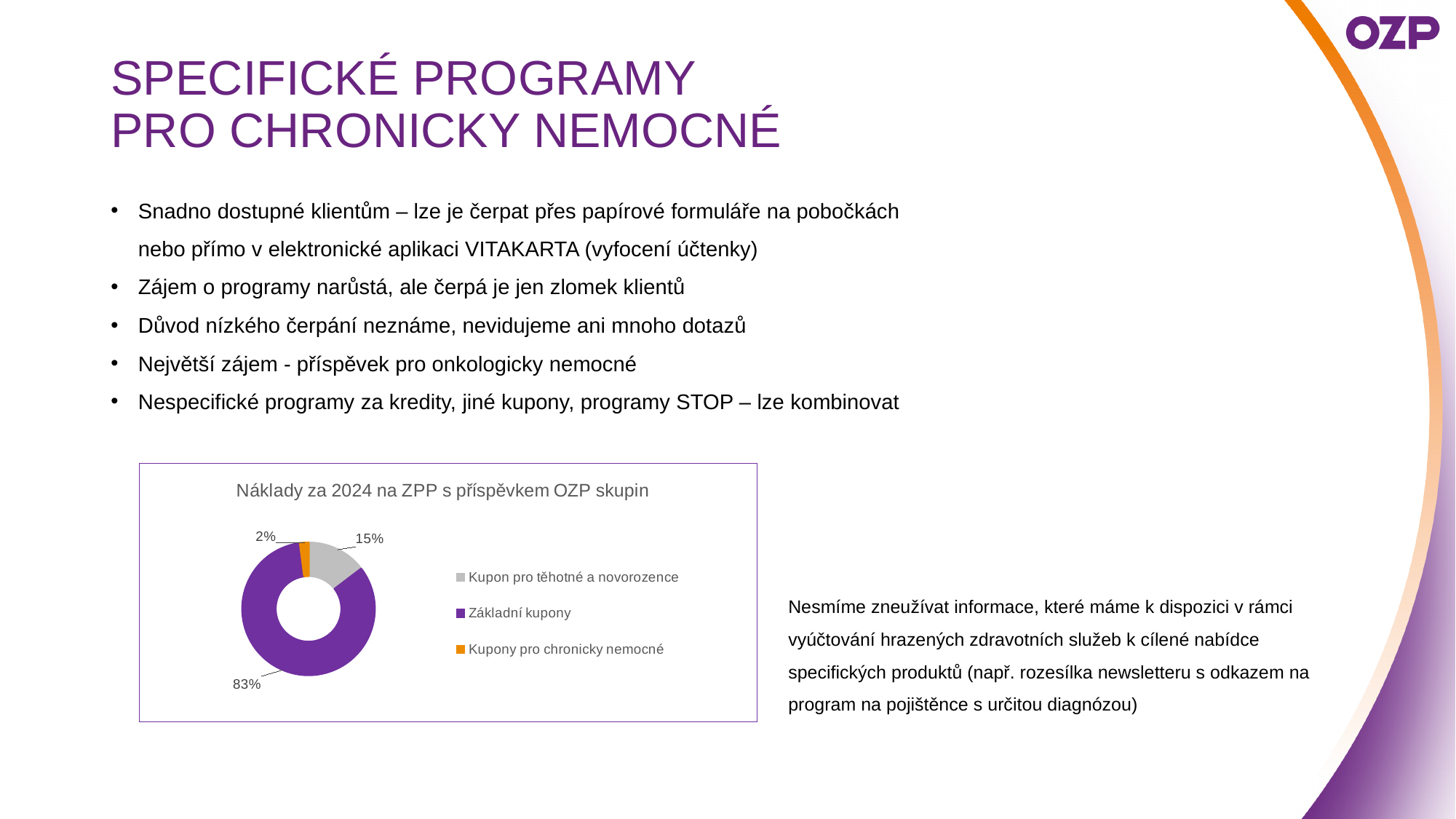
Which colour represents Kupony pro chronicky nemocné in the chart? Orange What share of the doughnut chart is labelled for Kupony pro chronicky nemocné? 2% What share of the doughnut chart is labelled for Základní kupony? 83% What share of the doughnut chart is labelled for Kupon pro těhotné a novorozence? 15% Which category has the smallest slice in the chart? Kupony pro chronicky nemocné How many categories does the chart show? 3 What is the difference in percentage points between the Základní kupony slice and the Kupon pro těhotné a novorozence slice? 68 What is the combined share of Kupon pro těhotné a novorozence and Kupony pro chronicky nemocné? 17% What is the title of the chart? Náklady za 2024 na ZPP s příspěvkem OZP skupin Which category has the largest slice in the chart? Základní kupony Which slice is larger: Kupon pro těhotné a novorozence or Kupony pro chronicky nemocné? Kupon pro těhotné a novorozence What kind of chart is shown on the slide? Doughnut chart